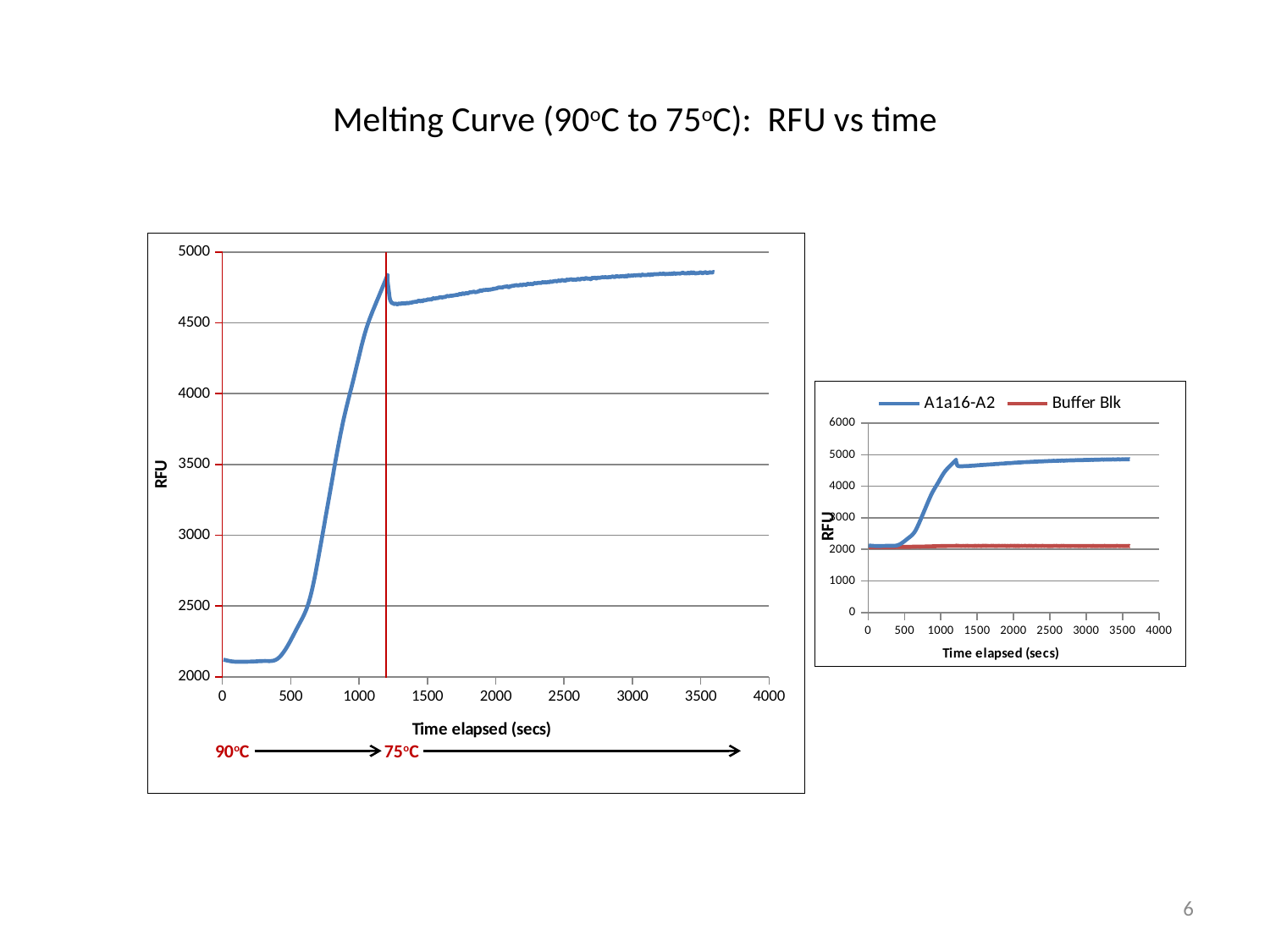
In the large chart on the left, does the RFU value rise or fall between 500 and 1000 secs? rise In the large chart on the left, is the RFU value at 1000 secs greater or less than 4000? greater In the small chart on the right, is the Buffer Blk value at 2000 secs greater or less than 3000? less How many series does the legend of the small chart on the right list? 2 In the small chart on the right, is the A1a16-A2 value at 3500 secs greater or less than 4000? greater In the large chart on the left, does the RFU value rise or fall between 1500 and 3500 secs? rise What kind of chart is the large chart on the left of the slide? line chart What are the two legend entries in the small chart on the right? A1a16-A2 and Buffer Blk What is the x-axis title of the large chart on the left? Time elapsed (secs) In the small chart on the right, which series has the higher value at 3000 secs, A1a16-A2 or Buffer Blk? A1a16-A2